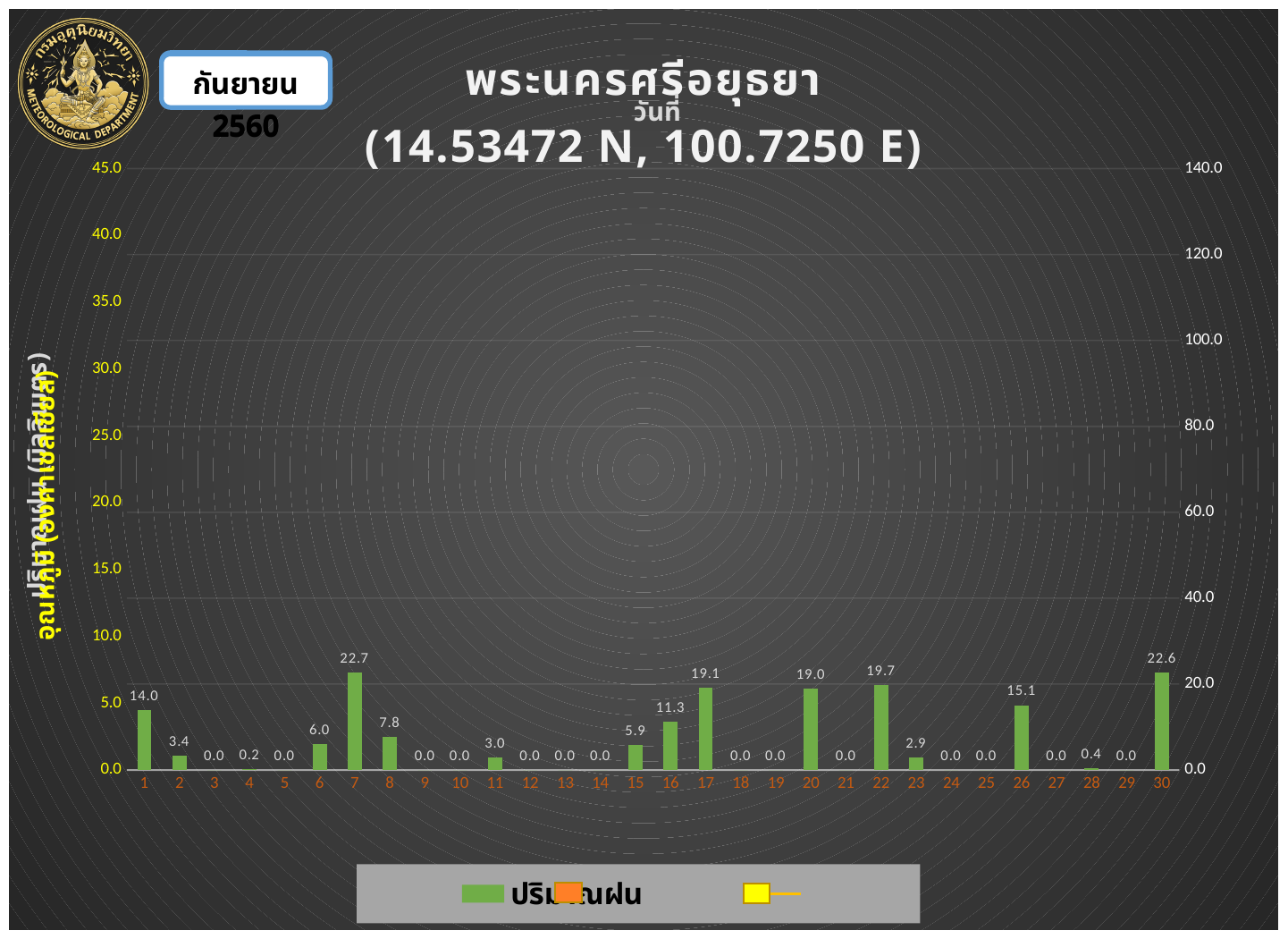
What is the difference between the rainfall values for day 22 and day 20? 0.7 What is the rainfall value shown for day 7? 22.7 How many days are shown on the x axis of the chart? 30 Which day has the highest rainfall value? 7 What is the rainfall value shown for day 26? 15.1 What is the rainfall value shown for day 30? 22.6 Is the rainfall value for day 7 greater or less than 20.0 on the right axis? greater What colour are the rainfall bars in the chart? Green What is the rainfall value shown for day 1? 14.0 Which has the larger rainfall value, day 17 or day 8? Day 17 What is the rainfall value shown for day 16? 11.3 What kind of chart is shown on the slide? Bar chart